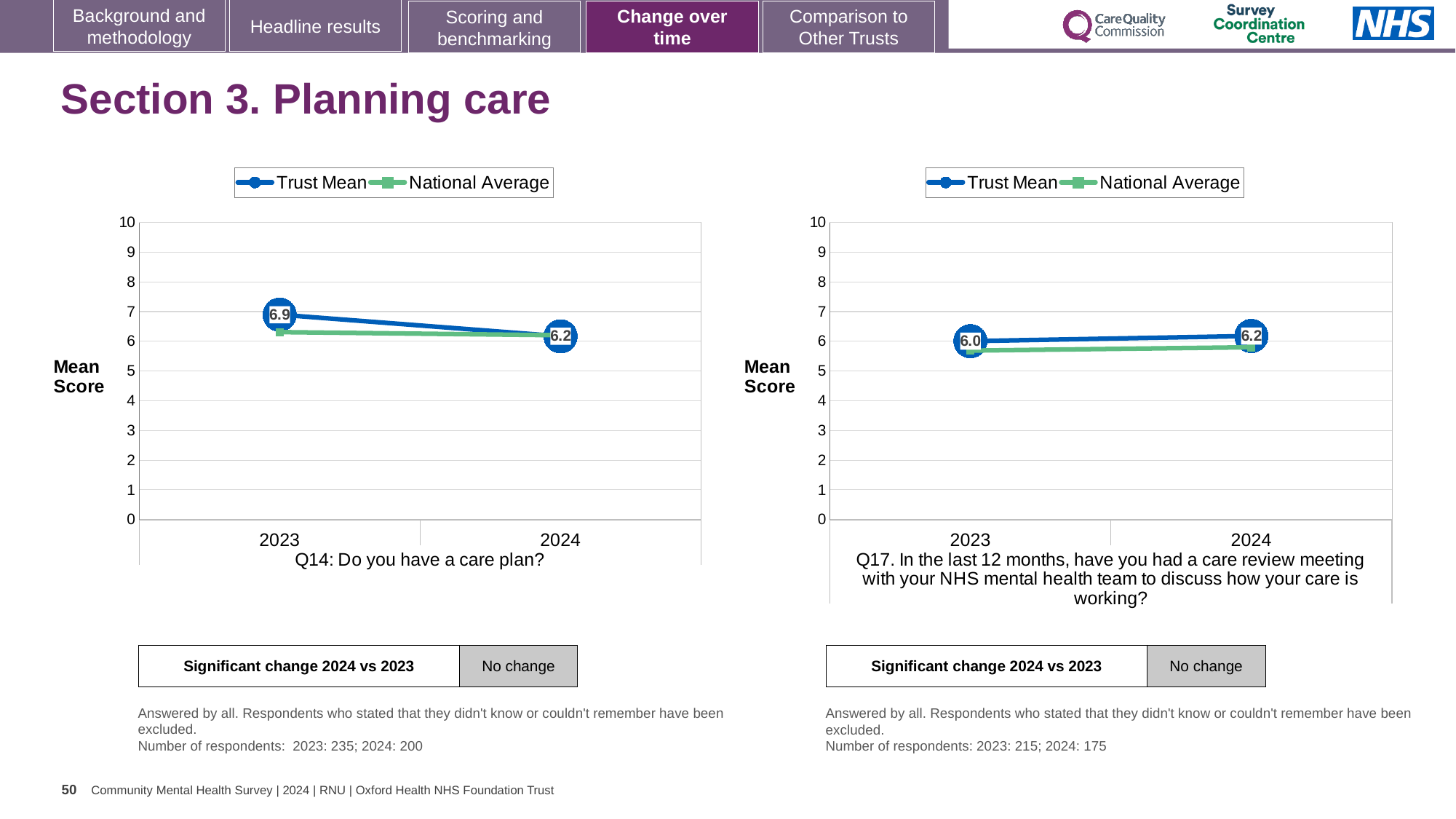
In the Q17 care review meeting chart, what is the difference between the Trust Mean in 2024 and in 2023? 0.2 In the Q14 care plan chart, what is the Trust Mean score for 2023? 6.9 In the Q17 care review meeting chart, what is the Trust Mean score for 2024? 6.2 In the Q17 care review meeting chart, is the National Average value for 2023 greater or less than 5? greater In the Q14 care plan chart, what is the Trust Mean score for 2024? 6.2 In the Q14 care plan chart, by how much did the Trust Mean fall from 2023 to 2024? 0.7 In the Q14 care plan chart, is the National Average value for 2023 greater or less than 7? less In the Q17 care review meeting chart, does the Trust Mean rise or fall from 2023 to 2024? rise How many series does the legend of the Q17 care review meeting chart list? 2 What kind of chart is the Q14 care plan chart? line chart In the Q17 care review meeting chart, what is the Trust Mean score for 2023? 6.0 In the Q14 care plan chart, does the Trust Mean rise or fall from 2023 to 2024? fall